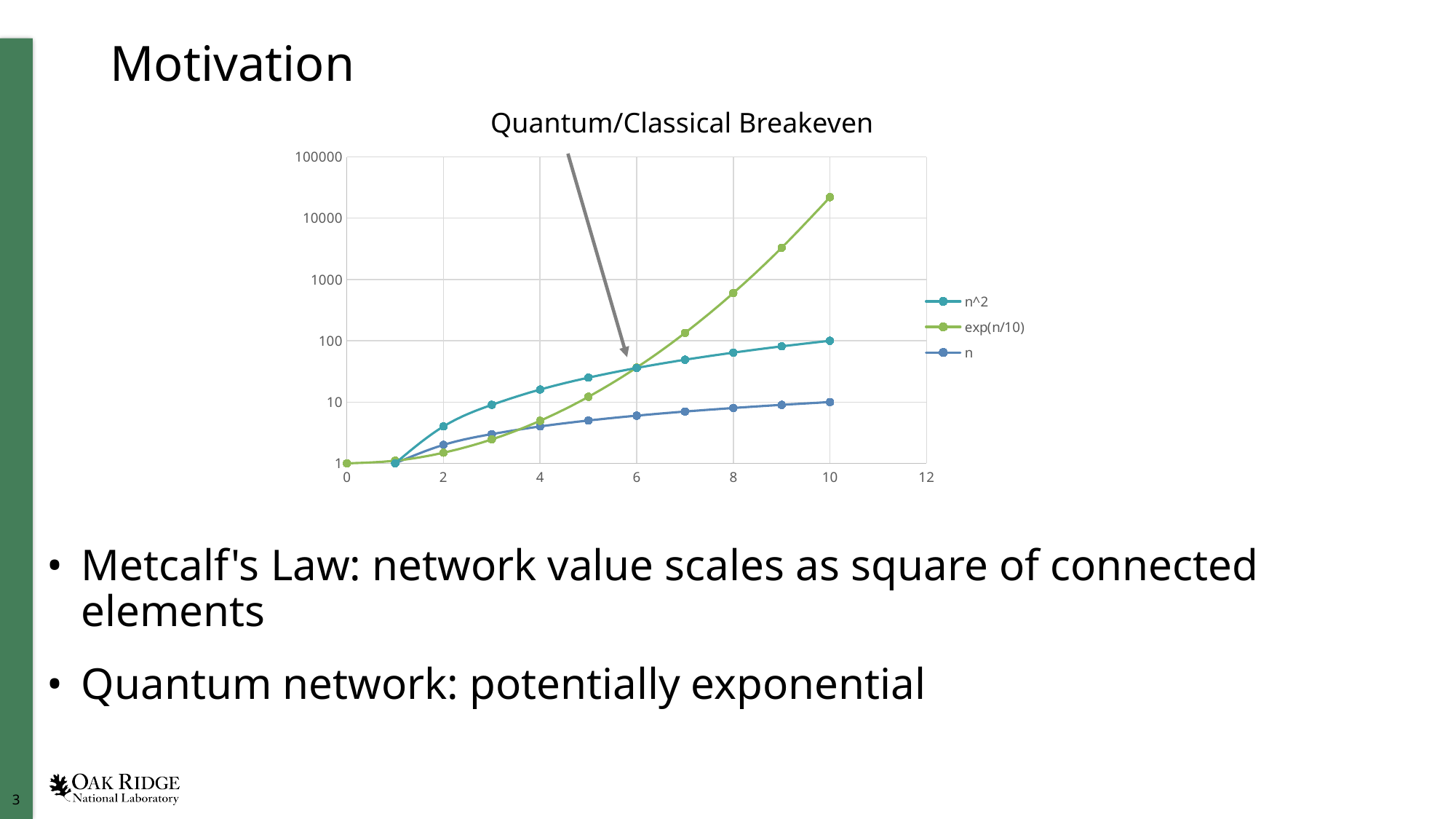
Is the value of exp(n/10) at x = 10 greater or less than 10000? greater What are the three series named in the legend? n^2, exp(n/10), n What kind of chart is shown on the slide? line chart Is the value of exp(n/10) at x = 8 greater or less than 100? greater What is the annotation text above the chart pointing to the crossing of the curves? Quantum/Classical Breakeven Which series has the highest value at x = 10? exp(n/10) What is the value of the n series at x = 10? 10 At x = 4, which is larger: n^2 or exp(n/10)? n^2 Which series has the lowest value at x = 8? n How many series does the legend list? 3 Is the value of n^2 at x = 4 greater or less than 10? greater What is the value of the n^2 series at x = 10? 100